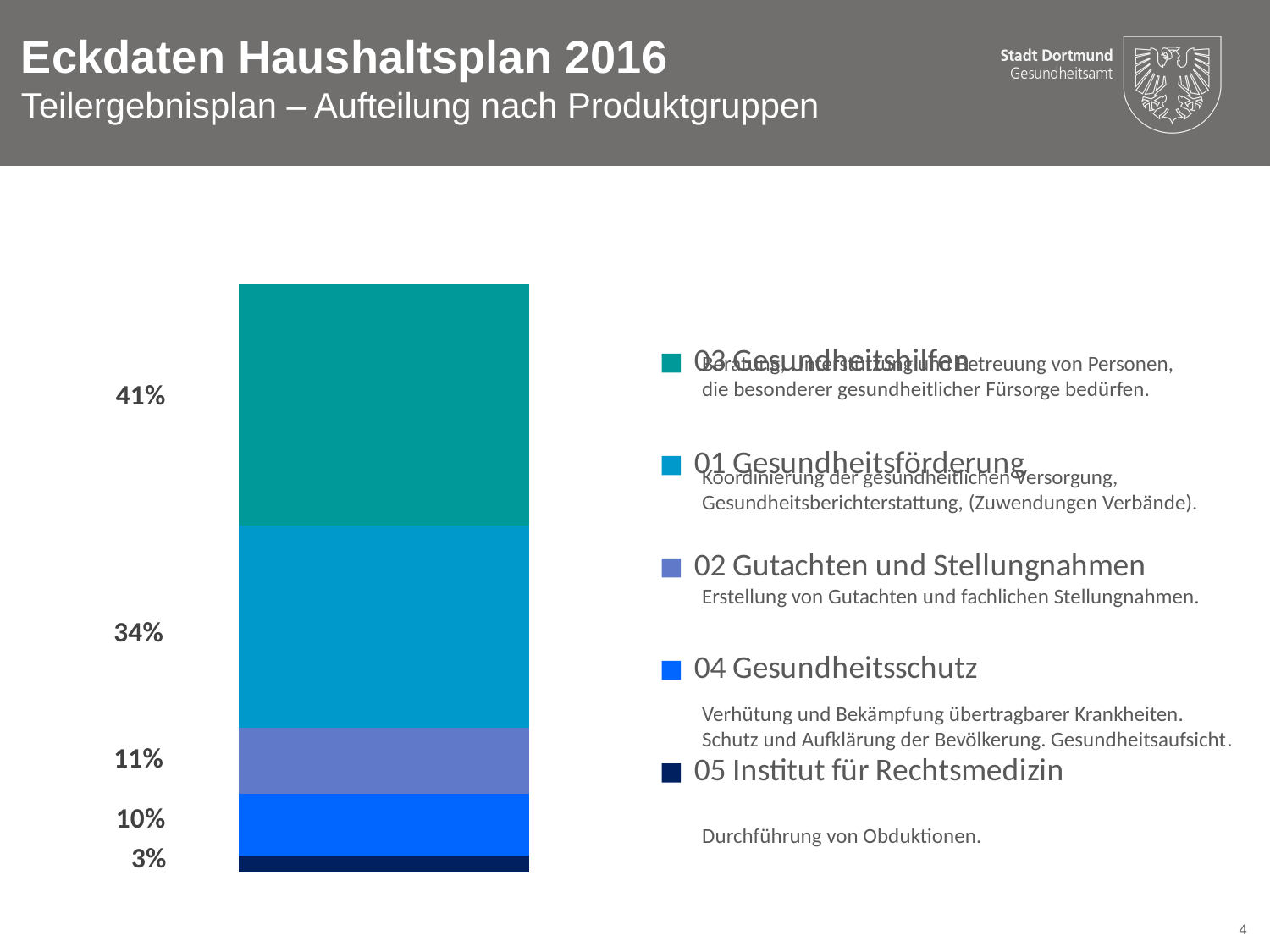
Which has the larger share, 02 Gutachten und Stellungnahmen or 04 Gesundheitsschutz? 02 Gutachten und Stellungnahmen What percentage share does 05 Institut für Rechtsmedizin have? 3% What percentage share does 03 Gesundheitshilfen have in the stacked bar? 41% What percentage share does 04 Gesundheitsschutz have? 10% What kind of chart is shown on the slide? Stacked bar chart How many product groups does the legend list? 5 What percentage share does 01 Gesundheitsförderung have in the stacked bar? 34% What colour is the segment for 05 Institut für Rechtsmedizin? Dark navy blue What percentage share does 02 Gutachten und Stellungnahmen have? 11% Which product group has the largest share in the stacked bar? 03 Gesundheitshilfen What is the difference in percentage points between 03 Gesundheitshilfen and 01 Gesundheitsförderung? 7 Which product group has the smallest share in the stacked bar? 05 Institut für Rechtsmedizin